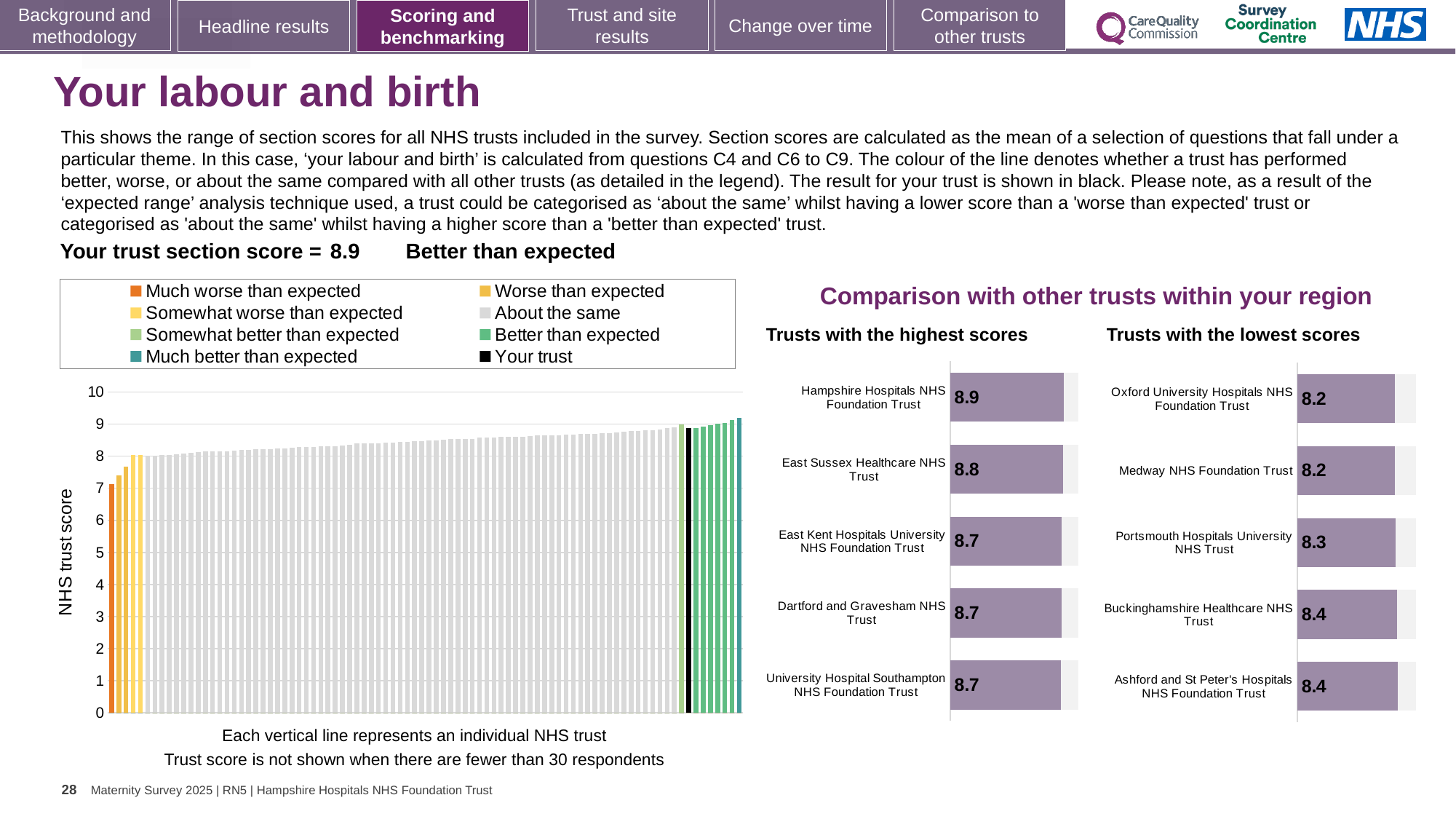
In the 'Trusts with the lowest scores' chart, what is the difference between the scores of Buckinghamshire Healthcare NHS Trust and Oxford University Hospitals NHS Foundation Trust? 0.2 What is the y-axis label of the large chart on the left? NHS trust score How many trusts are listed in the 'Trusts with the lowest scores' chart? 5 In the 'Trusts with the highest scores' chart, which has the larger score: Hampshire Hospitals NHS Foundation Trust or East Kent Hospitals University NHS Foundation Trust? Hampshire Hospitals NHS Foundation Trust In the 'Trusts with the highest scores' chart, which trust has the highest score? Hampshire Hospitals NHS Foundation Trust In the large chart on the left, do the trust scores rise or fall from left to right? Rise In the large chart on the left, is the value of the leftmost (lowest) bar greater or less than 8? less What kind of chart is the large chart on the left showing all NHS trusts? Bar chart How many trusts are listed in the 'Trusts with the highest scores' chart? 5 How many entries does the legend above the large chart on the left list? 8 In the 'Trusts with the lowest scores' chart, what is the score for Portsmouth Hospitals University NHS Trust? 8.3 In the 'Trusts with the highest scores' chart, what is the score for East Sussex Healthcare NHS Trust? 8.8